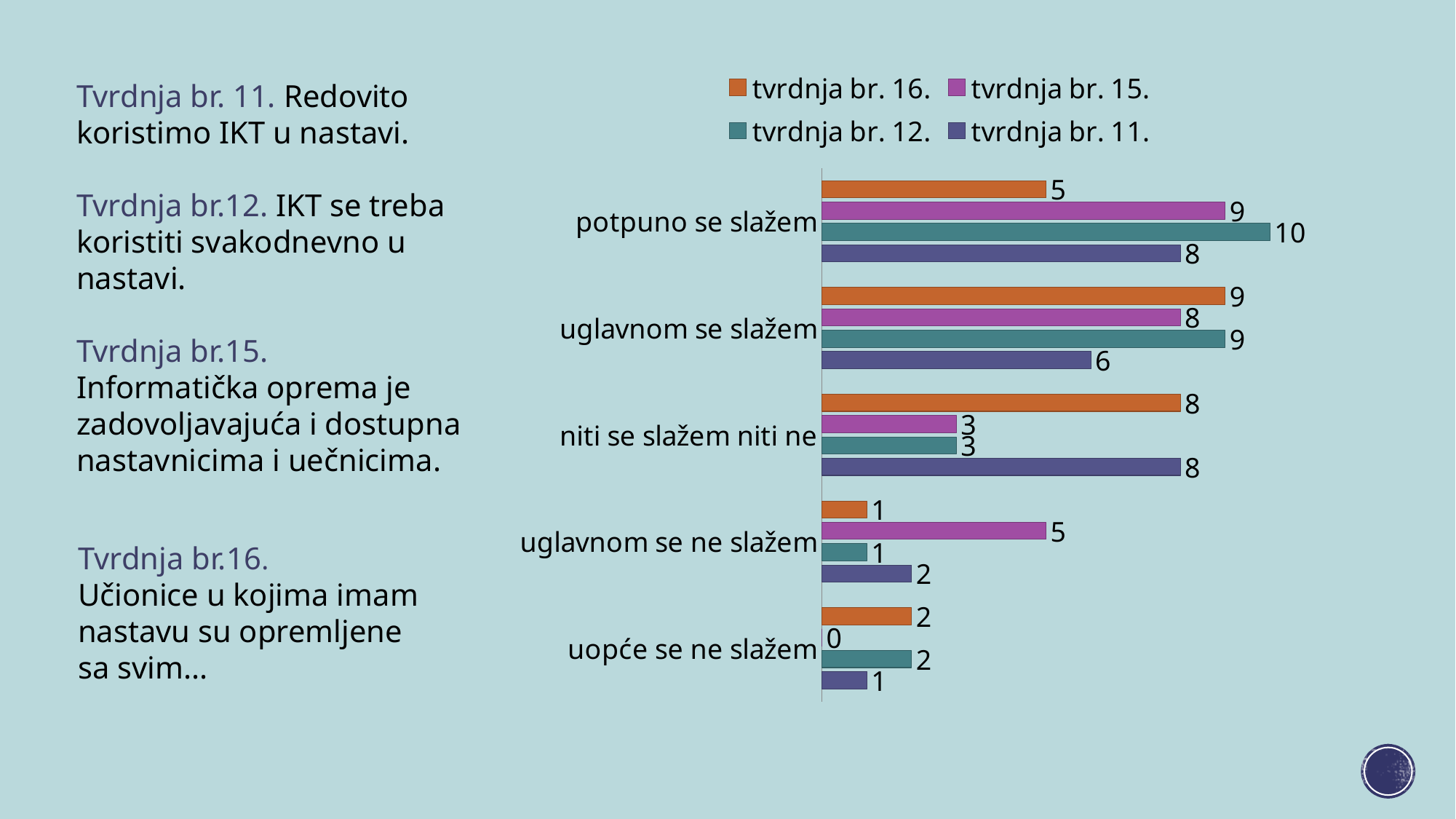
What is the value for tvrdnja br. 15. in the 'uopće se ne slažem' category? 0 What type of chart is shown on the slide? bar chart Which category has the lowest value for tvrdnja br. 16.? uglavnom se ne slažem How many response categories are shown on the chart? 5 Which series has the highest value in the 'potpuno se slažem' category? tvrdnja br. 12. Which series is shown in orange in the legend? tvrdnja br. 16. How many series does the legend list? 4 What is the value for tvrdnja br. 15. in the 'uglavnom se ne slažem' category? 5 In the 'uglavnom se slažem' category, which is larger: tvrdnja br. 16. or tvrdnja br. 11.? tvrdnja br. 16. What is the value for tvrdnja br. 12. in the 'potpuno se slažem' category? 10 What is the difference between tvrdnja br. 16. and tvrdnja br. 15. in the 'niti se slažem niti ne' category? 5 What is the value for tvrdnja br. 11. in the 'uglavnom se slažem' category? 6